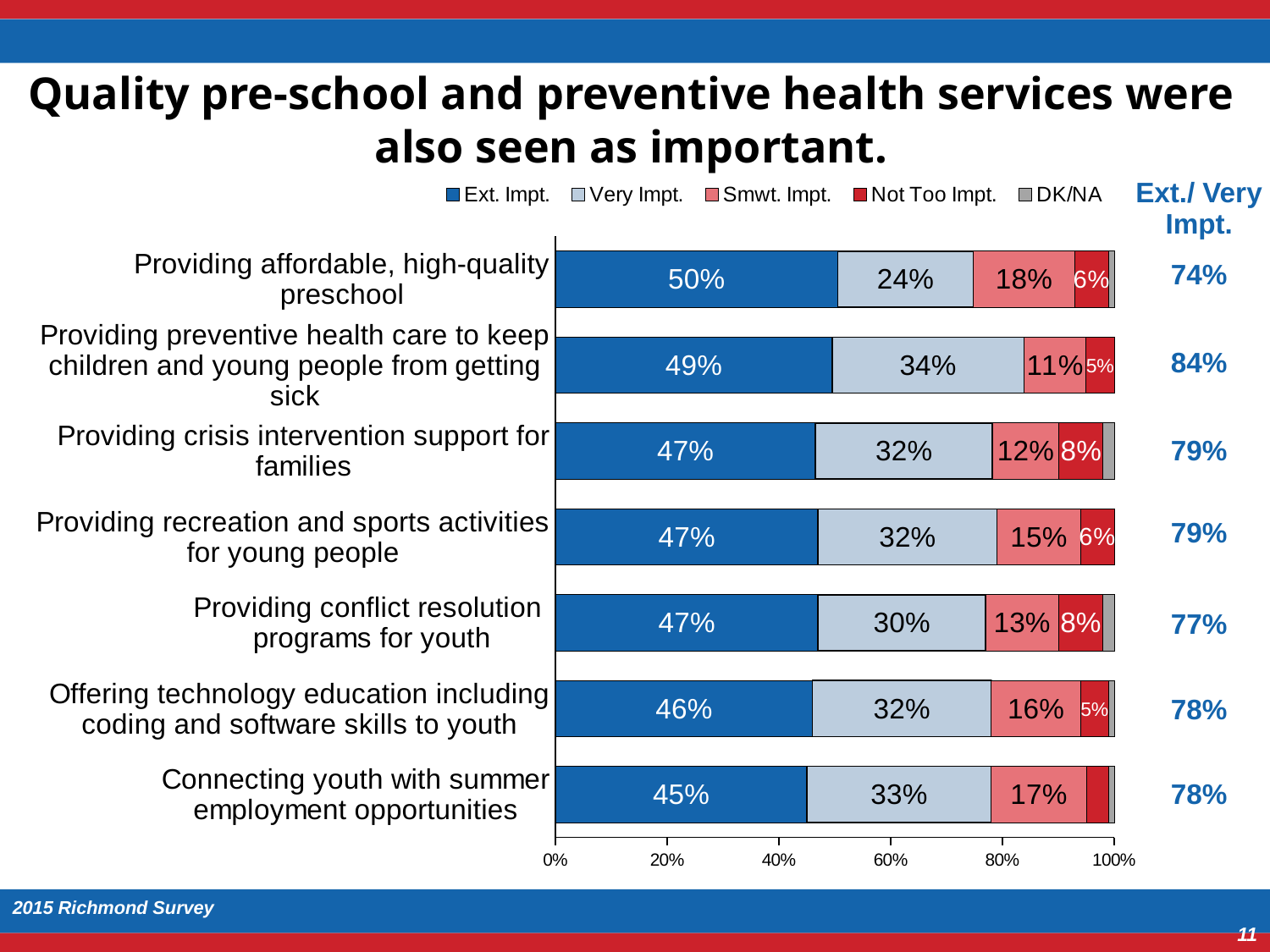
What is the Very Impt. value for 'Providing preventive health care to keep children and young people from getting sick'? 34% What is the Not Too Impt. value for 'Providing conflict resolution programs for youth'? 8% What percentage of respondents rated 'Providing affordable, high-quality preschool' as Ext. Impt.? 50% What kind of chart is shown on the slide? Stacked bar chart Which has a larger Smwt. Impt. value: 'Providing affordable, high-quality preschool' or 'Providing recreation and sports activities for young people'? Providing affordable, high-quality preschool Which legend entry is represented by the dark blue segments? Ext. Impt. Which category has the highest Ext. Impt. percentage? Providing affordable, high-quality preschool How many series does the legend list? 5 What is the combined Ext./Very Impt. figure shown for 'Providing crisis intervention support for families'? 79% Which category has the lowest Ext. Impt. percentage? Connecting youth with summer employment opportunities How many categories (services) are shown in the chart? 7 How much higher is the Very Impt. value for preventive health care than for affordable, high-quality preschool? 10 percentage points